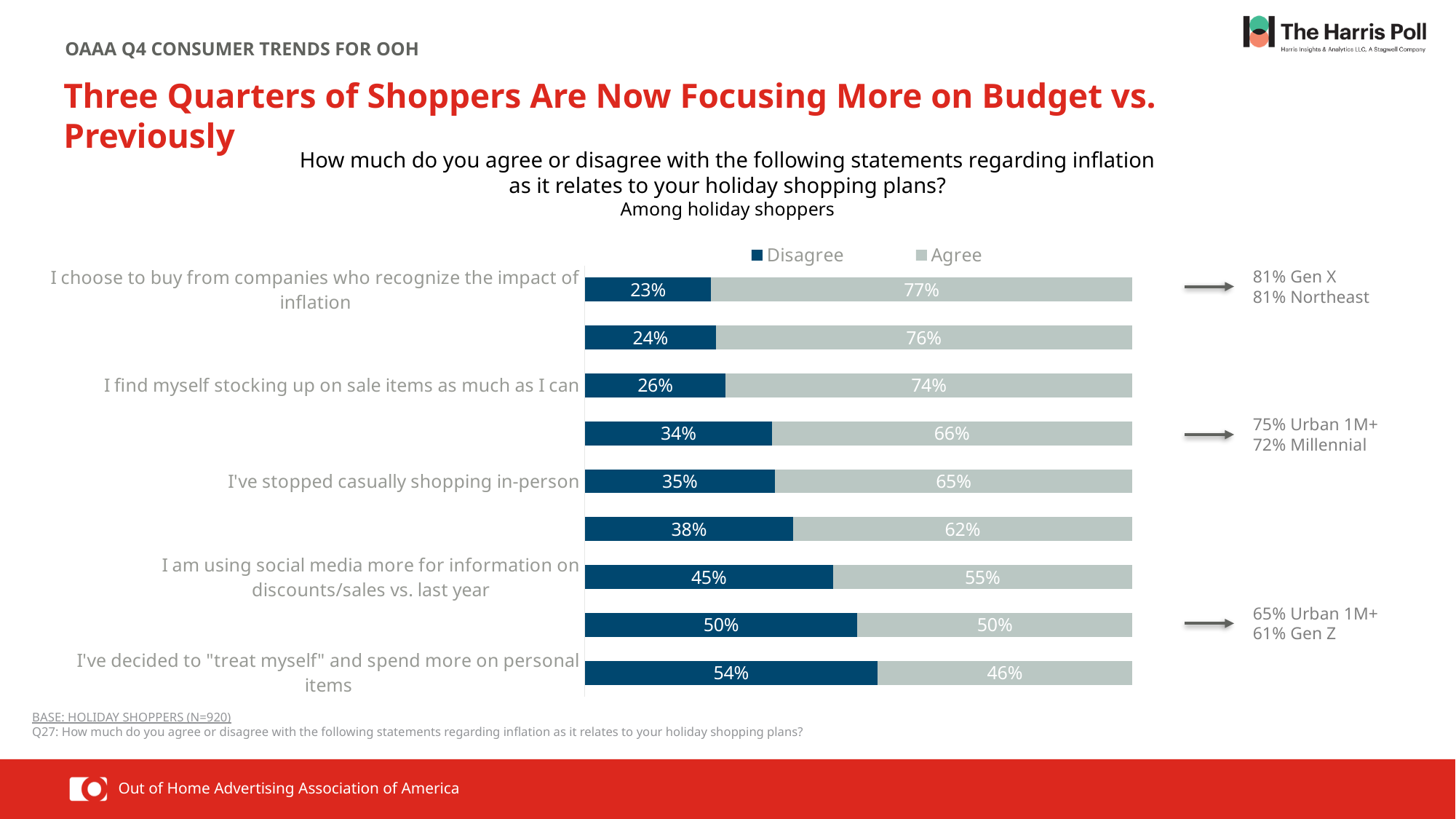
Which labeled statement has the highest Disagree percentage? I've decided to "treat myself" and spend more on personal items What is the Disagree value for "I am using social media more for information on discounts/sales vs. last year"? 45% What is the difference between the Agree percentages for "I find myself stocking up on sale items as much as I can" and "I've stopped casually shopping in-person"? 9 percentage points What percentage disagree with "I find myself stocking up on sale items as much as I can"? 26% What percentage of holiday shoppers agree with "I choose to buy from companies who recognize the impact of inflation"? 77% Which is larger: the Agree share for "I am using social media more for information on discounts/sales vs. last year" or the Agree share for "I've decided to 'treat myself' and spend more on personal items"? I am using social media more for information on discounts/sales vs. last year Which statement has the highest Agree percentage? I choose to buy from companies who recognize the impact of inflation What percentage agree with "I've decided to 'treat myself' and spend more on personal items"? 46% What is the Agree value for "I've stopped casually shopping in-person"? 65% How many bars are plotted in the chart? 9 How many series does the chart legend list? 2 What kind of chart is shown on the slide? Stacked bar chart